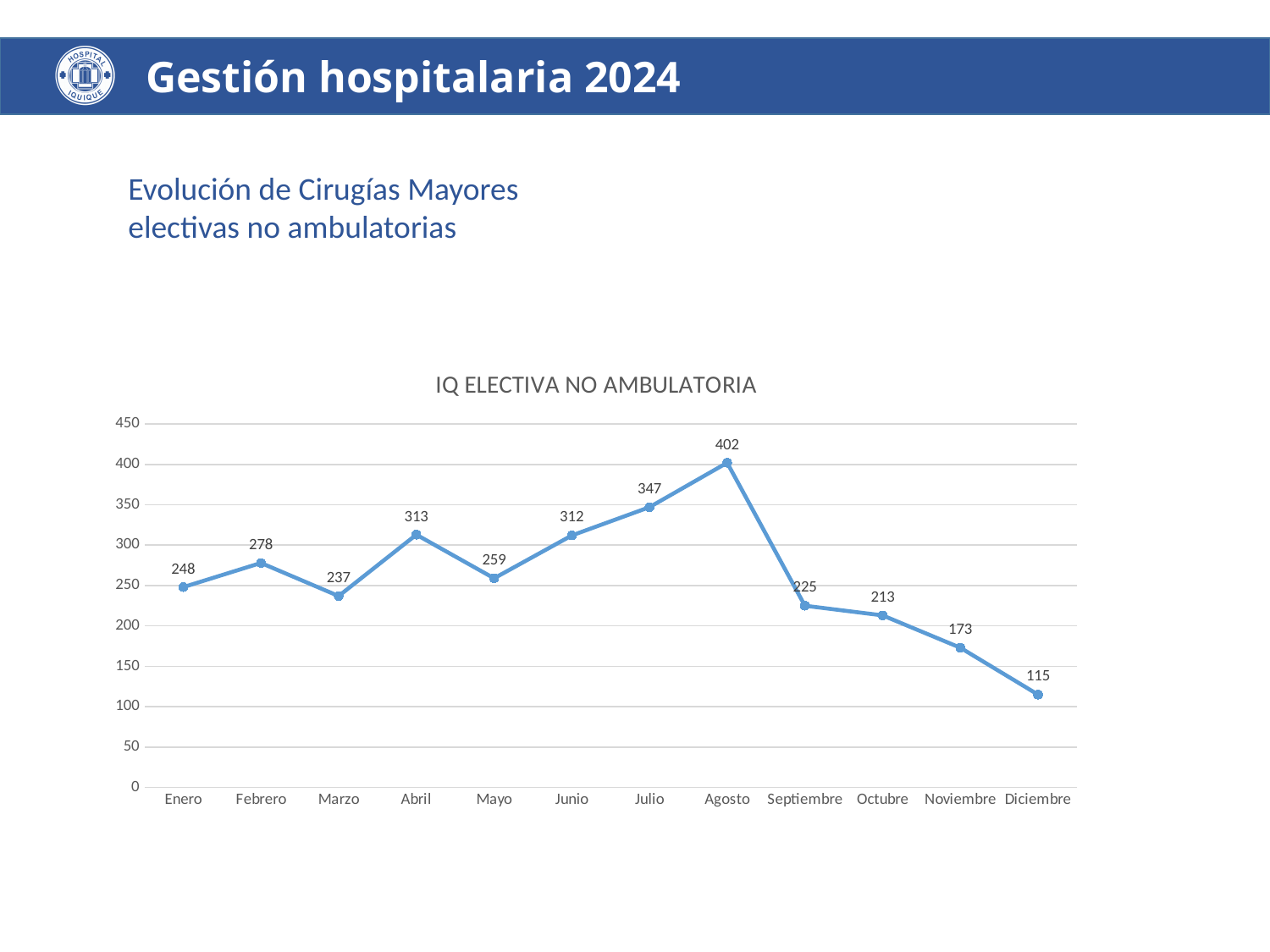
What is the value for Agosto in the IQ ELECTIVA NO AMBULATORIA chart? 402 What is the difference between the values for Agosto and Septiembre? 177 Is the value for Julio greater or less than 300? greater Which month has the highest value? Agosto What is the value for Marzo? 237 What kind of chart is shown on the slide? Line chart Do the values rise or fall from Agosto to Diciembre? Fall What is the value for Diciembre? 115 How many months are plotted on the x axis? 12 What is the title of the chart? IQ ELECTIVA NO AMBULATORIA Which is larger, the value for Abril or the value for Junio? Abril Which month has the lowest value? Diciembre